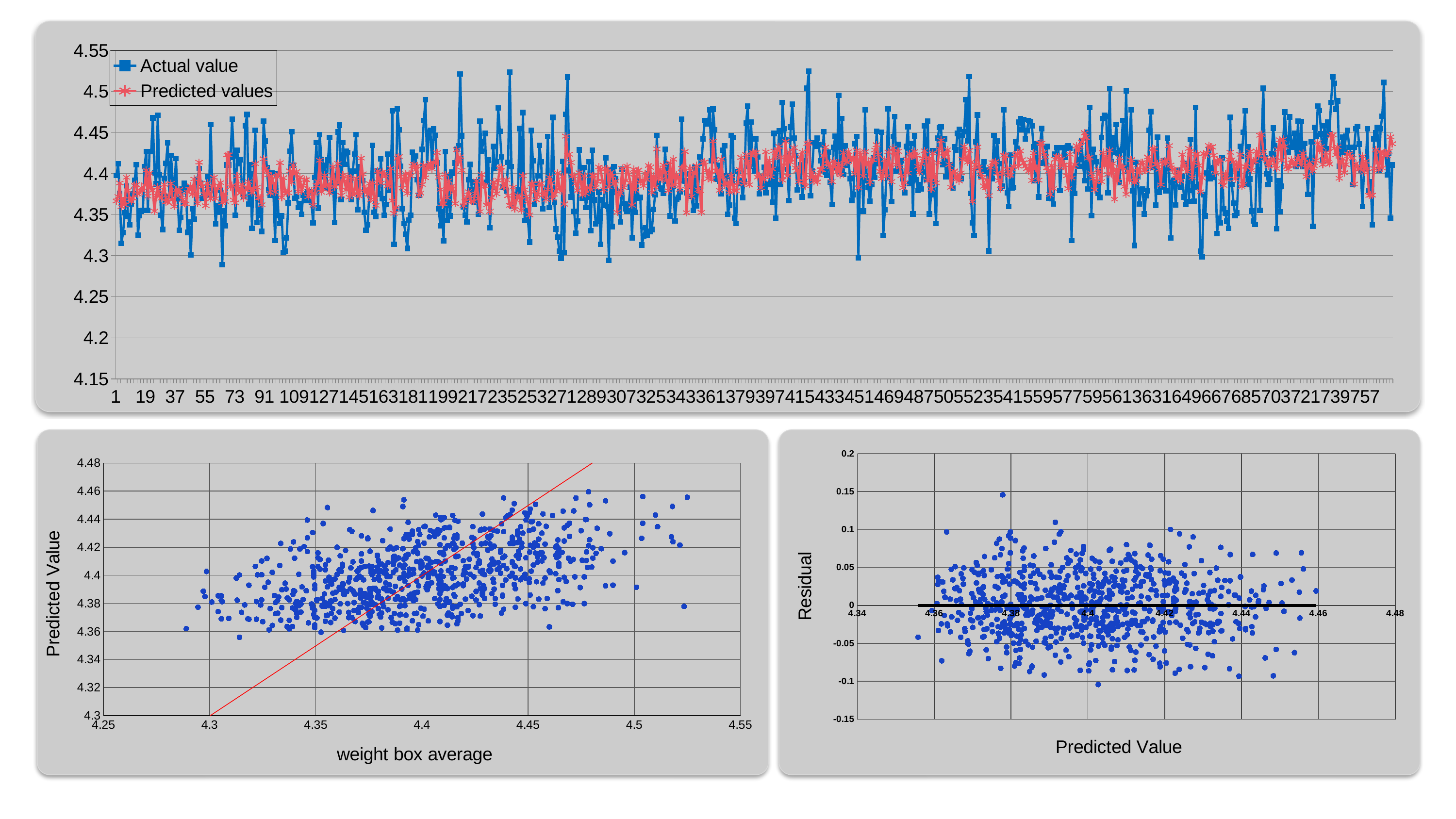
In the top chart, is the highest Predicted value greater or less than 4.5? less In the bottom-right chart with the y axis labelled 'Residual', is the highest residual greater or less than 0.1? greater What are the two series named in the legend of the top chart? Actual value and Predicted values In the top chart, which series is drawn in red? Predicted values In the top chart, is the lowest Actual value greater or less than 4.25? greater What kind of chart is the top chart on the slide? line chart What kind of chart is the bottom-left chart with the x axis labelled 'weight box average'? scatter chart In the top chart, do the Predicted values generally rise or fall from left to right along the x axis? rise How many series does the legend of the top chart list? 2